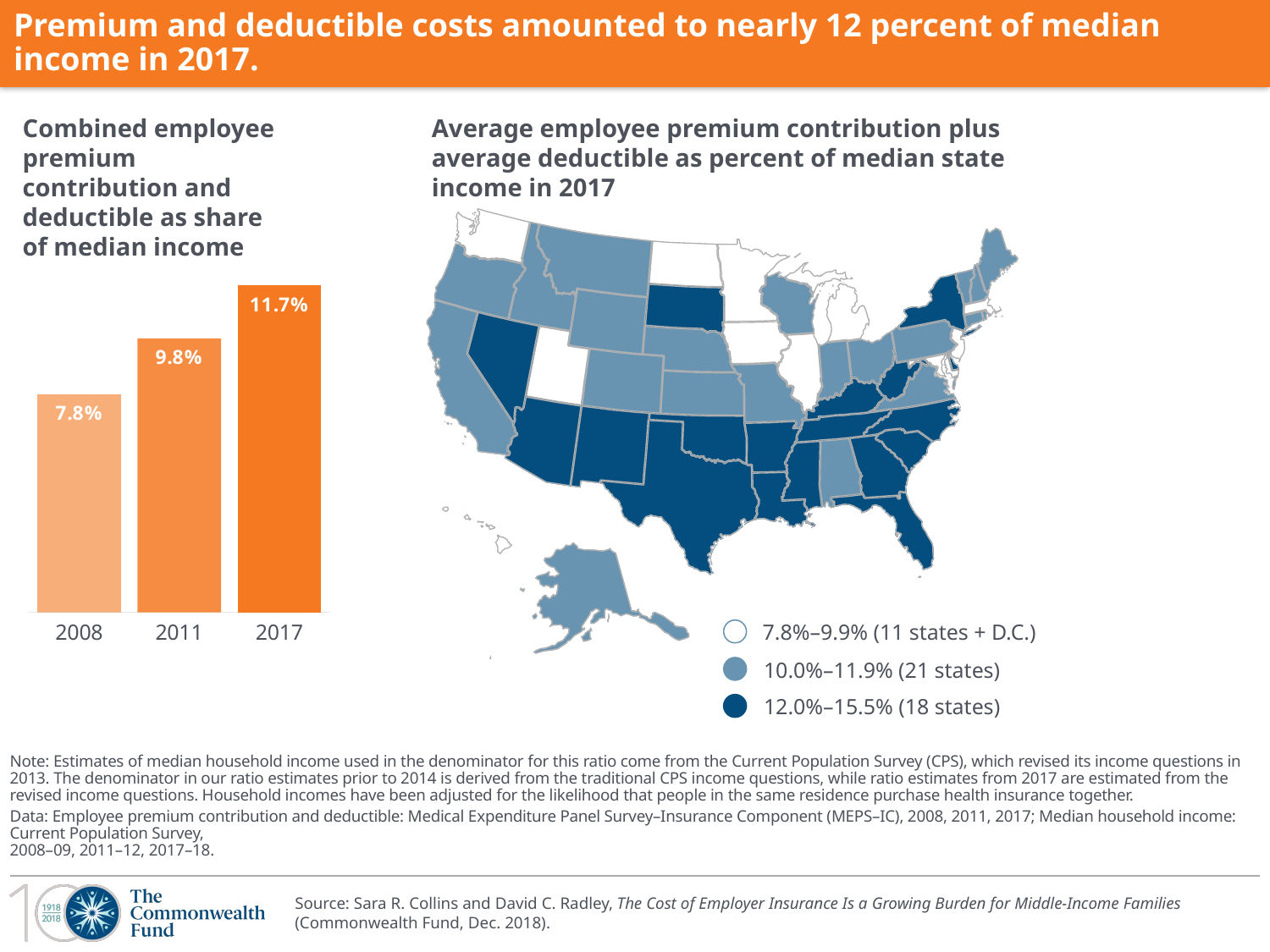
In the bar chart on the left, which year has the lowest value? 2008 In the bar chart on the left, which year has the highest value? 2017 In the bar chart on the left, what value is shown for 2017? 11.7% In the bar chart on the left, what was the combined employee premium contribution and deductible as a share of median income in 2008? 7.8% In the bar chart on the left, do the values rise or fall from 2008 to 2017? Rise How many years are shown in the bar chart on the left? 3 In the bar chart on the left, which is larger, the value for 2011 or the value for 2017? 2017 In the bar chart on the left, what value is shown for 2011? 9.8% What kind of chart is shown on the left of the slide? Bar chart In the bar chart on the left, what is the difference between the 2011 and 2008 values? 2.0 percentage points In the map on the right, how many states fall in the 12.0%–15.5% category according to the legend? 18 states In the bar chart on the left, what is the difference between the 2017 and 2008 values? 3.9 percentage points